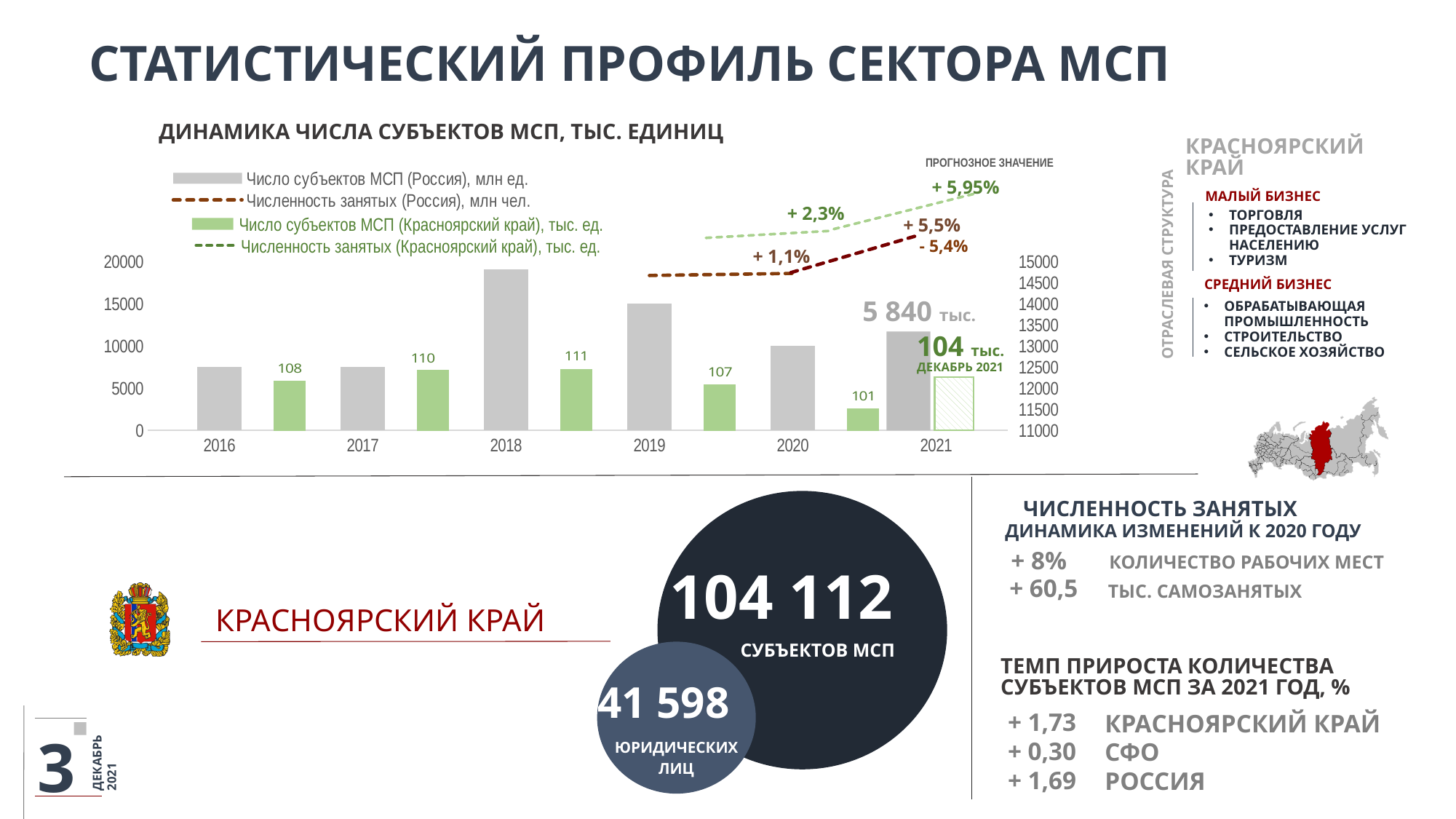
In which year is the green bar (Число субъектов МСП, Красноярский край) highest? 2018 How many series does the chart legend list? 4 What value is labelled on the gray bar for 2021 in the chart? 5 840 тыс. What is the value of the green bar for 2020 in the chart? 101 What is the value of the green bar for 2018 in the chart 'Динамика числа субъектов МСП'? 111 Do the green bar values rise or fall from 2018 to 2020? fall What is the difference between the green bar values for 2018 and 2020? 10 How many years are shown on the x axis of the chart? 6 What is the forecast value (прогнозное значение) shown for Krasnoyarsk Krai in 2021? 104 тыс. In which year is the green bar (Число субъектов МСП, Красноярский край) lowest? 2020 Which year has a larger green bar value, 2019 or 2020? 2019